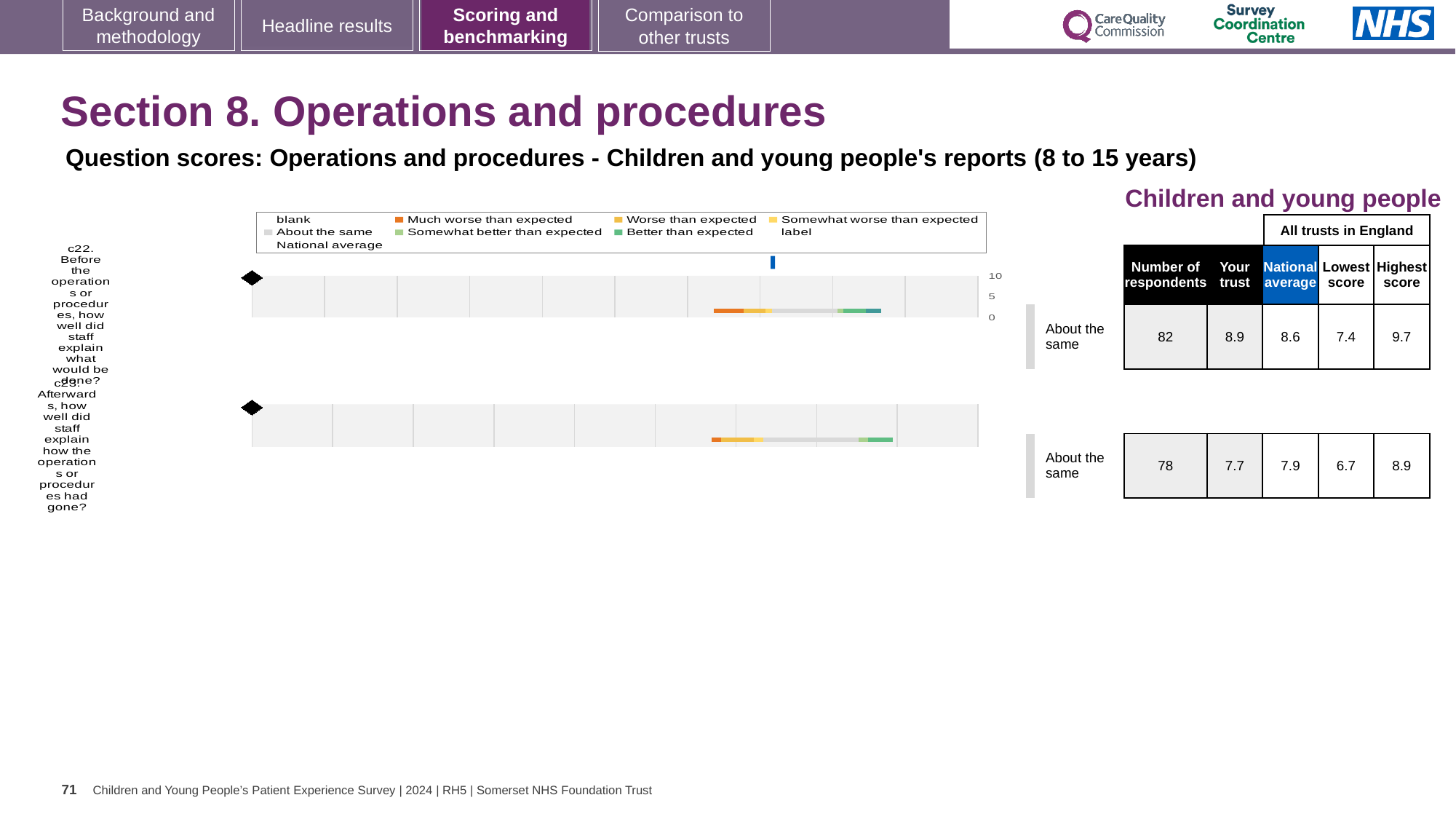
For question c23, what is the Lowest score among all trusts in England? 6.7 For question c22 (Before the operations or procedures, how well did staff explain what would be done?), what is the 'Your trust' score? 8.9 For question c22, what is the National average score? 8.6 For question c22, what is the Highest score among all trusts in England? 9.7 How many questions (c22 and c23) have a benchmark bar chart on this slide? 2 For question c22, which is larger: the 'Your trust' score or the National average? Your trust For question c23 (Afterwards, how well did staff explain how the operations or procedures had gone?), what is the 'Your trust' score? 7.7 In the chart legend, what colour represents 'Much worse than expected'? orange For question c23, what is the difference between the Highest score (8.9) and the Lowest score (6.7)? 2.2 How many respondents answered question c23? 78 What kind of chart is used to show the benchmark bands for questions c22 and c23? bar chart What benchmark category is shown next to both the c22 and c23 charts? About the same